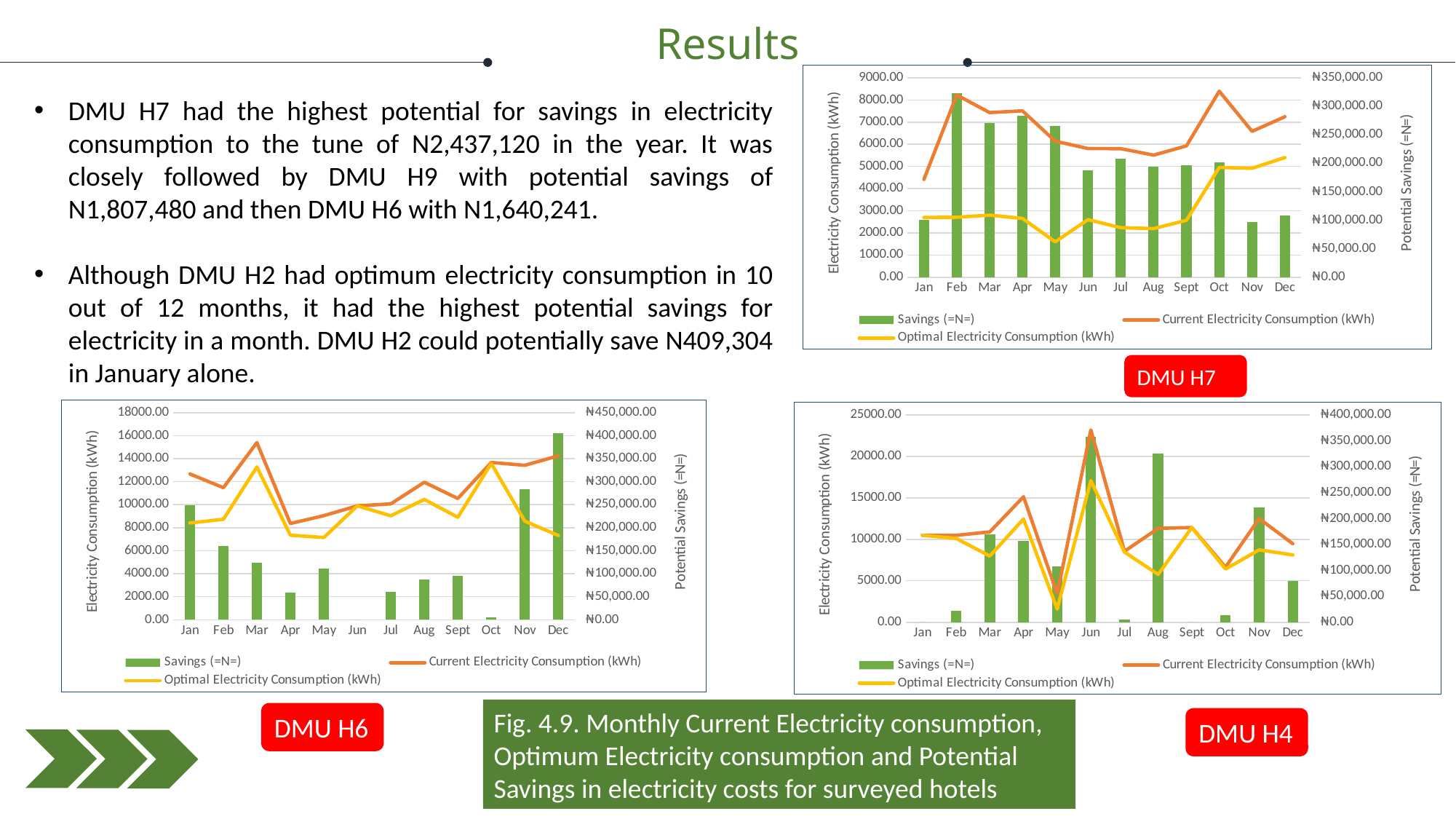
How many months are plotted along the x axis of the DMU H4 chart? 12 In the DMU H6 chart, in which month does the Current Electricity Consumption line reach its highest point? Mar In the DMU H7 chart, does the Optimal Electricity Consumption line rise or fall from Sept to Dec? Rise How many series does the legend of the DMU H6 chart list? 3 What colour are the Savings bars in the DMU H6 chart? Green What kind of chart is the DMU H7 chart? A combined bar and line chart In the DMU H4 chart, which month has the tallest Savings bar? Jun In the DMU H7 chart, which month has the tallest Savings bar? Feb In the DMU H4 chart, is the Savings bar for Aug taller or shorter than the Savings bar for Nov? Taller